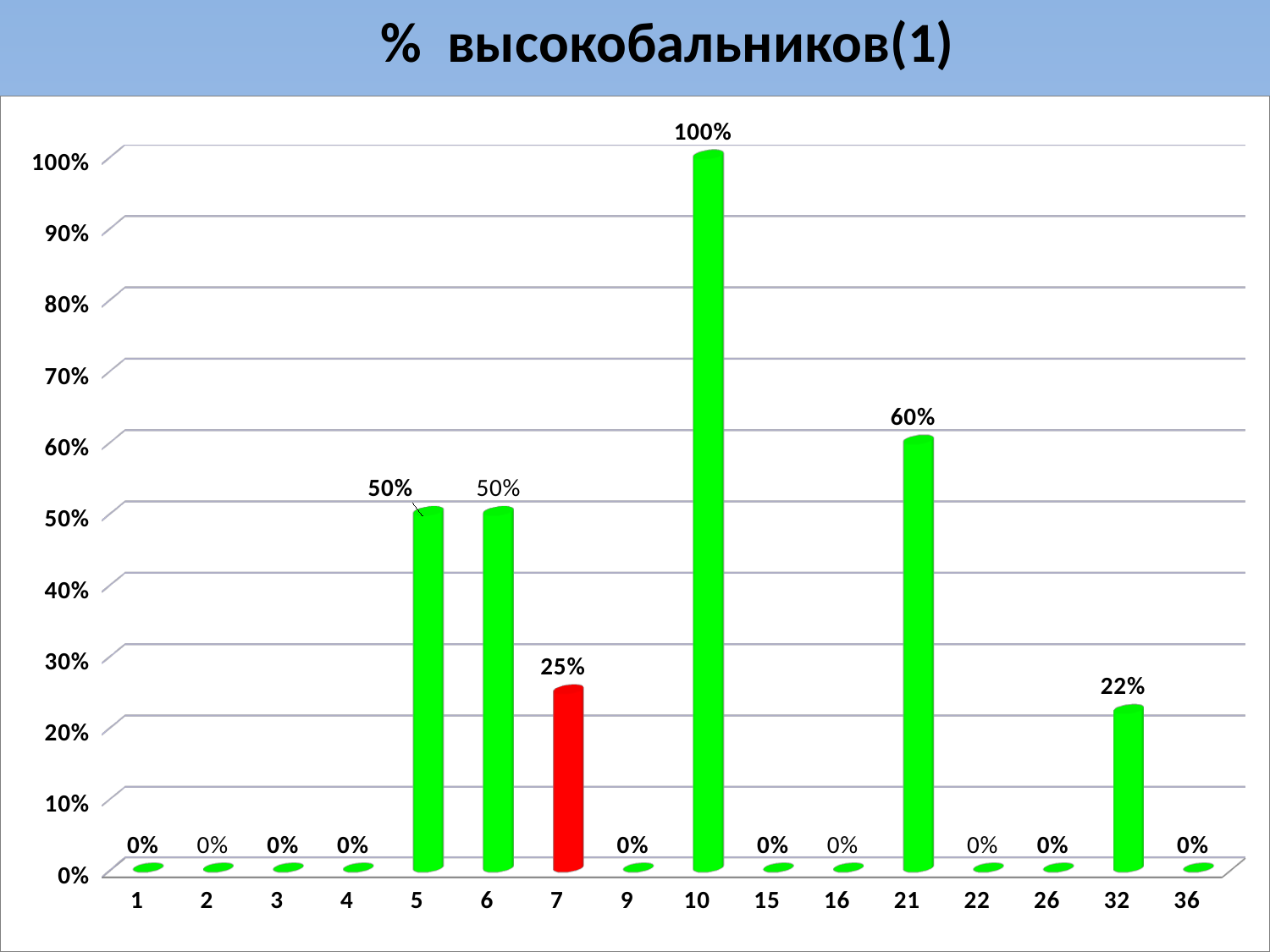
What is the title of the chart? % высокобальников(1) Which category has the highest value? 10 How many categories are shown on the x axis? 16 What is the value for category 7? 25% What kind of chart is this? bar chart Which category's bar is coloured red? 7 What is the value for category 21? 60% What is the difference between the values for categories 7 and 32? 3% Which is larger, the value for category 21 or the value for category 5? 21 What is the difference between the values for categories 10 and 21? 40% What is the value for category 32? 22% What is the value for category 10? 100%